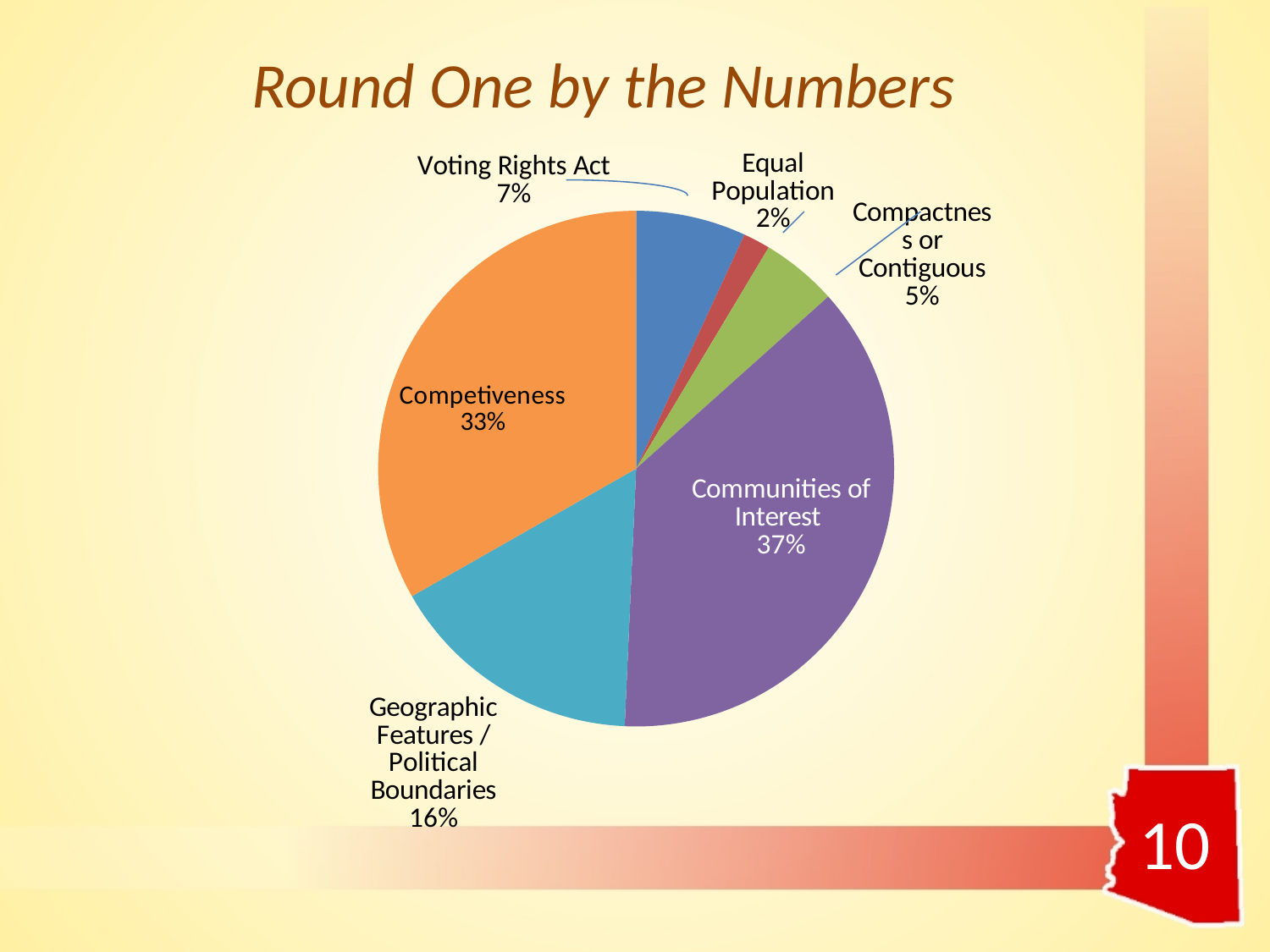
What share of the pie does Competiveness have? 33% How many slices does the pie chart have? 6 Which category has the smallest slice of the pie? Equal Population What is the title of the slide containing the pie chart? Round One by the Numbers Which is larger, the share for Voting Rights Act or the share for Compactness or Contiguous? Voting Rights Act What share of the pie does Communities of Interest have? 37% What share of the pie does Geographic Features / Political Boundaries have? 16% What kind of chart is shown on the slide? pie chart What is the difference in percentage points between Communities of Interest and Competiveness? 4 Which category has the largest slice of the pie? Communities of Interest